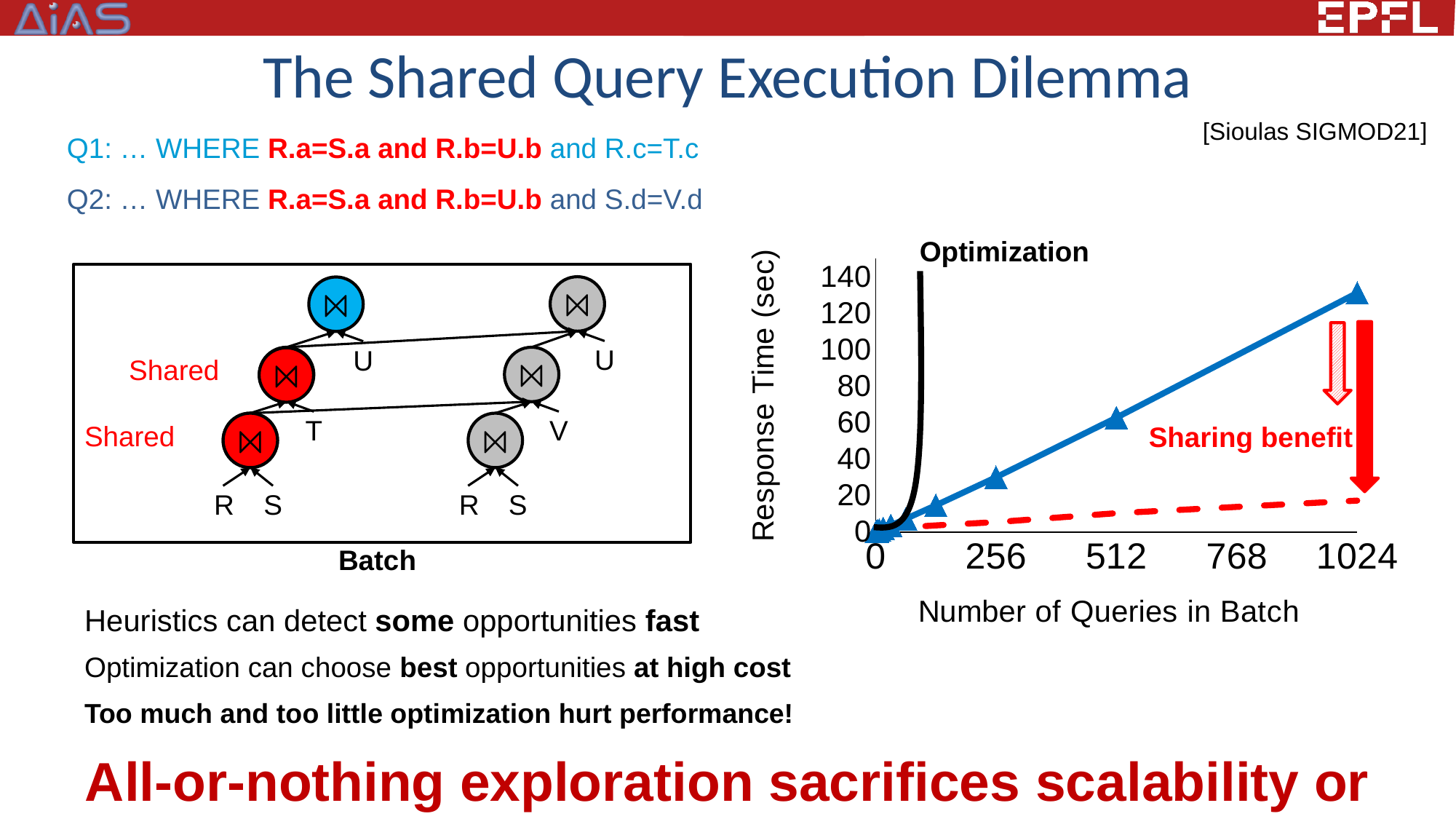
What is the highest tick value shown on the y axis of the chart? 140 What is the largest number of queries shown on the x axis of the chart? 1024 What kind of chart is shown on the right side of the slide? line chart What is the label of the y axis of the chart? Response Time (sec) What is the label of the x axis of the chart? Number of Queries in Batch Is the value of the blue line at 1024 queries greater or less than 100 seconds? greater Does the blue line with triangle markers rise or fall as the number of queries in the batch increases? rise Is the value of the blue line at 512 queries greater or less than 40 seconds? greater How many tick labels are shown on the x axis of the chart? 5 At 1024 queries, which line shows the higher response time: the blue solid line or the red dashed line? the blue solid line Which curve in the chart is labelled 'Optimization': the black curve, the blue line, or the red dashed line? the black curve Is the value of the red dashed line at 1024 queries greater or less than 40 seconds? less